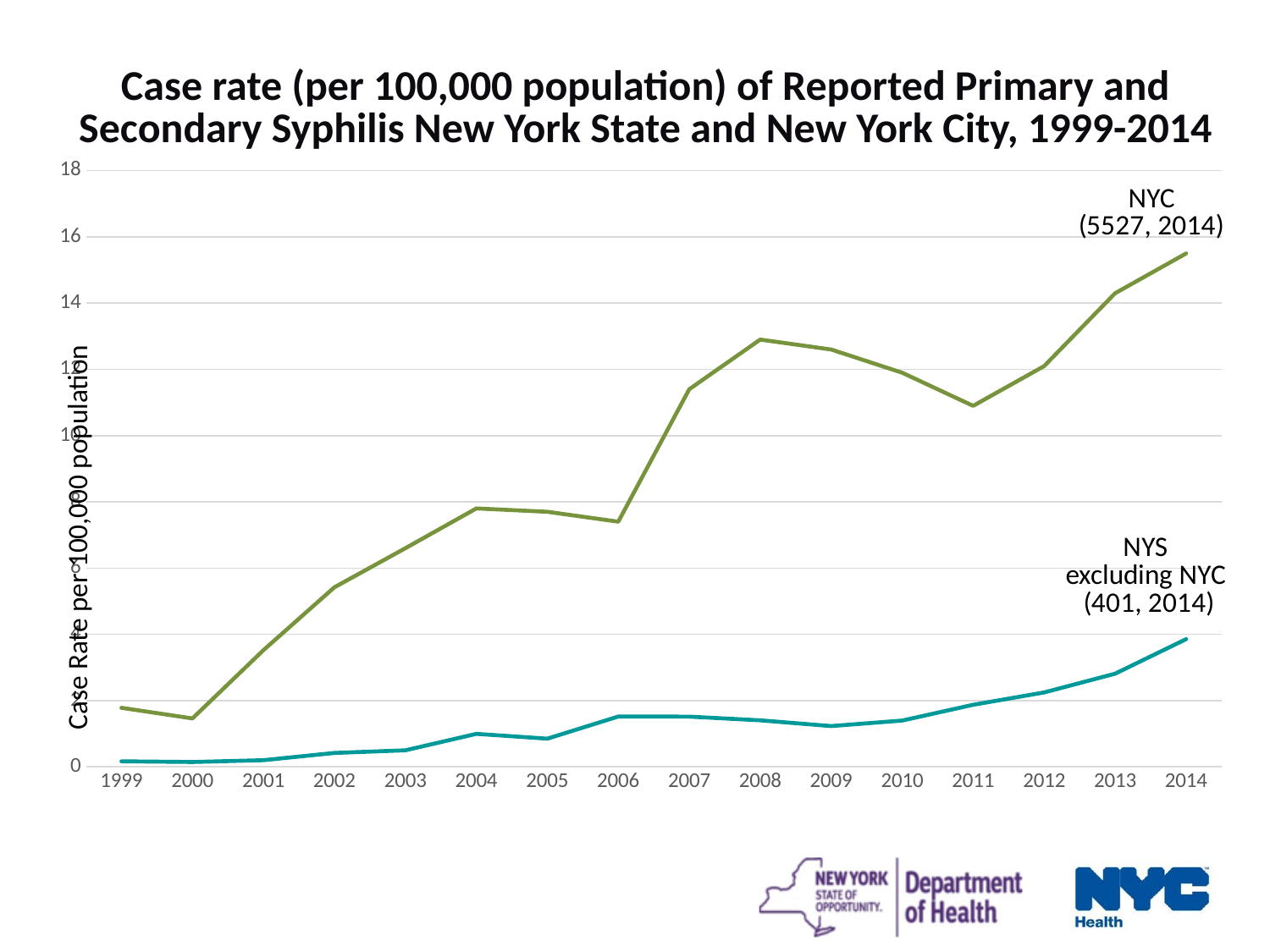
How many years are plotted along the x axis? 16 Does the NYS excluding NYC case rate rise or fall from 2009 to 2014? rise What kind of chart is shown on the slide? line chart Is the NYC case rate in 2008 greater or less than 12? greater In 2014, which series has the higher case rate, NYC or NYS excluding NYC? NYC What number of cases is shown in the annotation next to the NYC line for 2014? 5527 How many series are plotted on the chart? 2 In which year does the NYC series reach its highest case rate? 2014 Is the NYC case rate in 1999 greater or less than 4? less Is the NYS excluding NYC case rate in 2014 greater or less than 2? greater Does the NYC case rate rise or fall from 2011 to 2014? rise